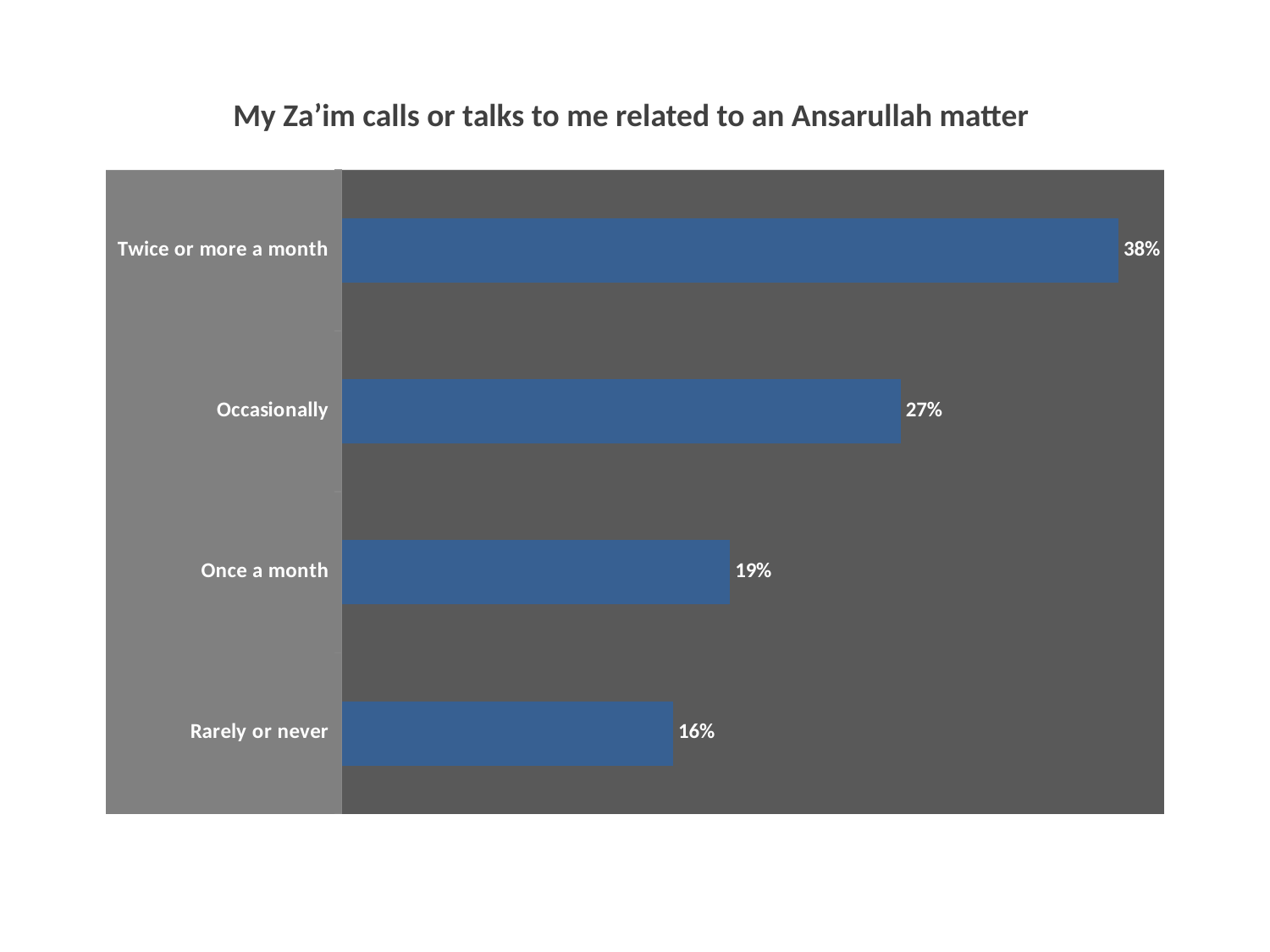
What is the value for "Once a month"? 19% Which category has the highest value? Twice or more a month Which category has the lowest value? Rarely or never What is the value for "Twice or more a month"? 38% What is the difference between the values for "Once a month" and "Rarely or never"? 3% What is the value for "Occasionally"? 27% What is the title of the chart? My Za'im calls or talks to me related to an Ansarullah matter Which is larger, the value for "Occasionally" or the value for "Once a month"? Occasionally What kind of chart is shown on the slide? Bar chart How many categories are shown in the chart? 4 What is the difference between the values for "Twice or more a month" and "Occasionally"? 11% What is the value for "Rarely or never"? 16%